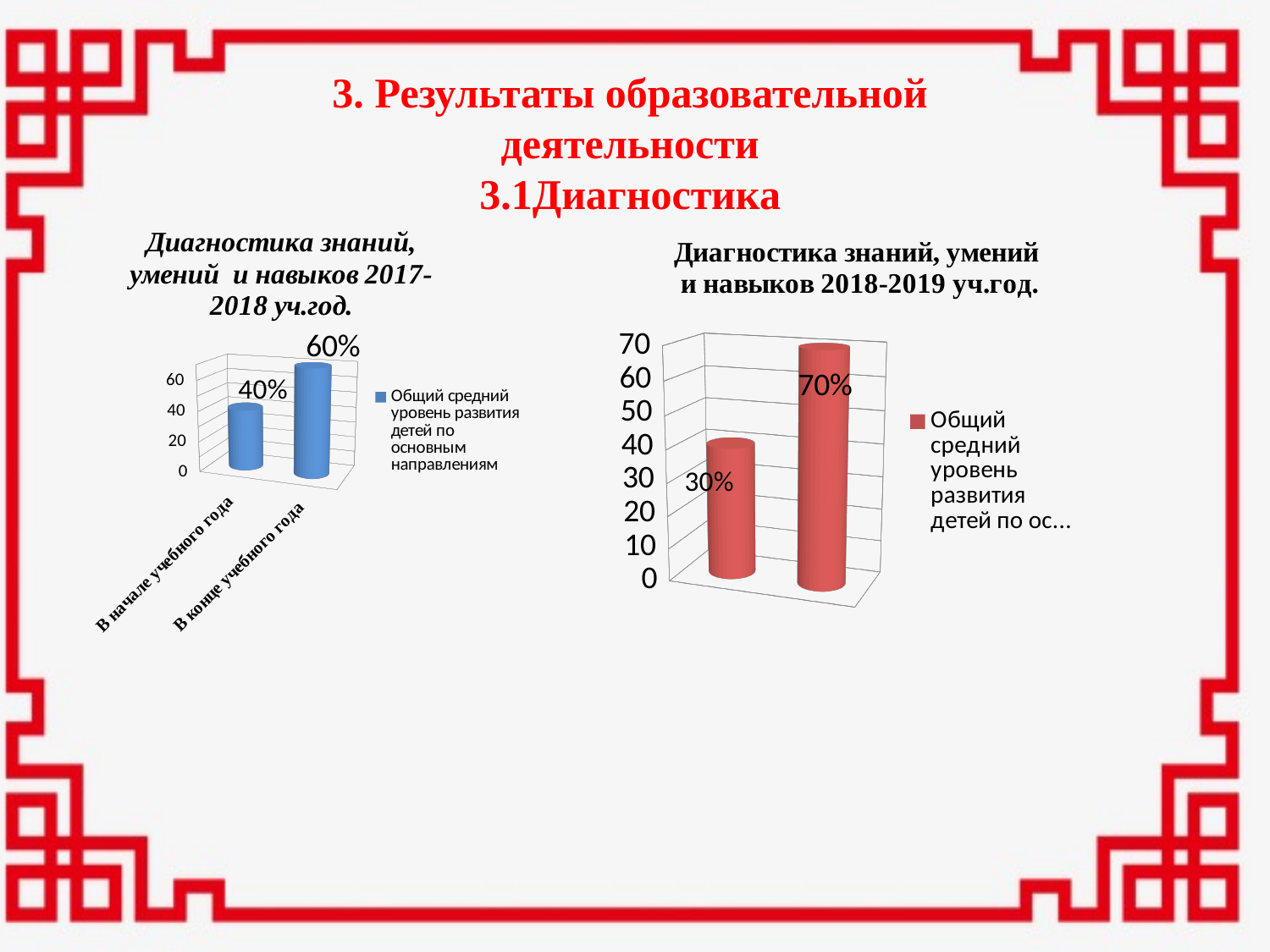
In the right chart (2018-2019 уч.год), what is the difference between the two bars? 40% What colour are the bars in the left chart (2017-2018 уч.год)? Blue In the left chart (2017-2018 уч.год), how many categories are plotted? 2 In the left chart (2017-2018 уч.год), what is the value for 'В начале учебного года'? 40% In the left chart (2017-2018 уч.год), which category has the higher value? В конце учебного года In the right chart (2018-2019 уч.год), what is the value of the second (right) bar? 70% In the right chart (2018-2019 уч.год), what is the value of the first (left) bar? 30% In the right chart (2018-2019 уч.год), how many series does the legend list? 1 What kind of chart is the right chart (2018-2019 уч.год)? Bar chart In the left chart (2017-2018 уч.год), what is the value for 'В конце учебного года'? 60% In the left chart (2017-2018 уч.год), what is the difference between the values for 'В конце учебного года' and 'В начале учебного года'? 20%